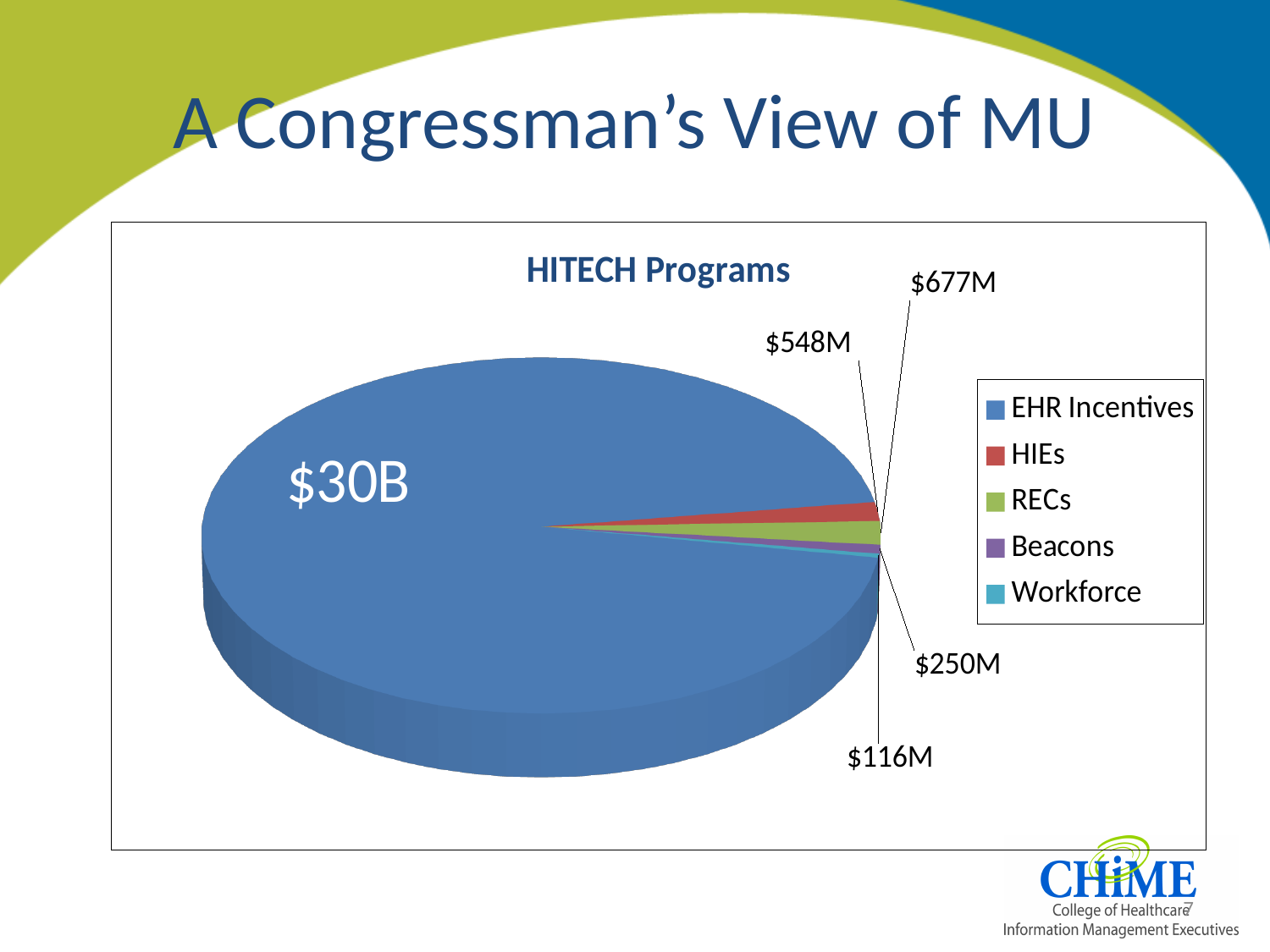
What is the title of the chart? HITECH Programs How many slices does the pie chart have? 5 What colour is the EHR Incentives slice? blue What is the value labeled for HIEs? $548M What type of chart is shown on the slide? pie chart How many categories does the legend list? 5 Which category has the largest slice of the pie? EHR Incentives Which is larger, EHR Incentives or HIEs? EHR Incentives What is the value labeled for RECs? $677M What is the value shown for EHR Incentives? $30B What is the smallest value labeled on the chart? $116M Which category has the smallest slice of the pie? Workforce